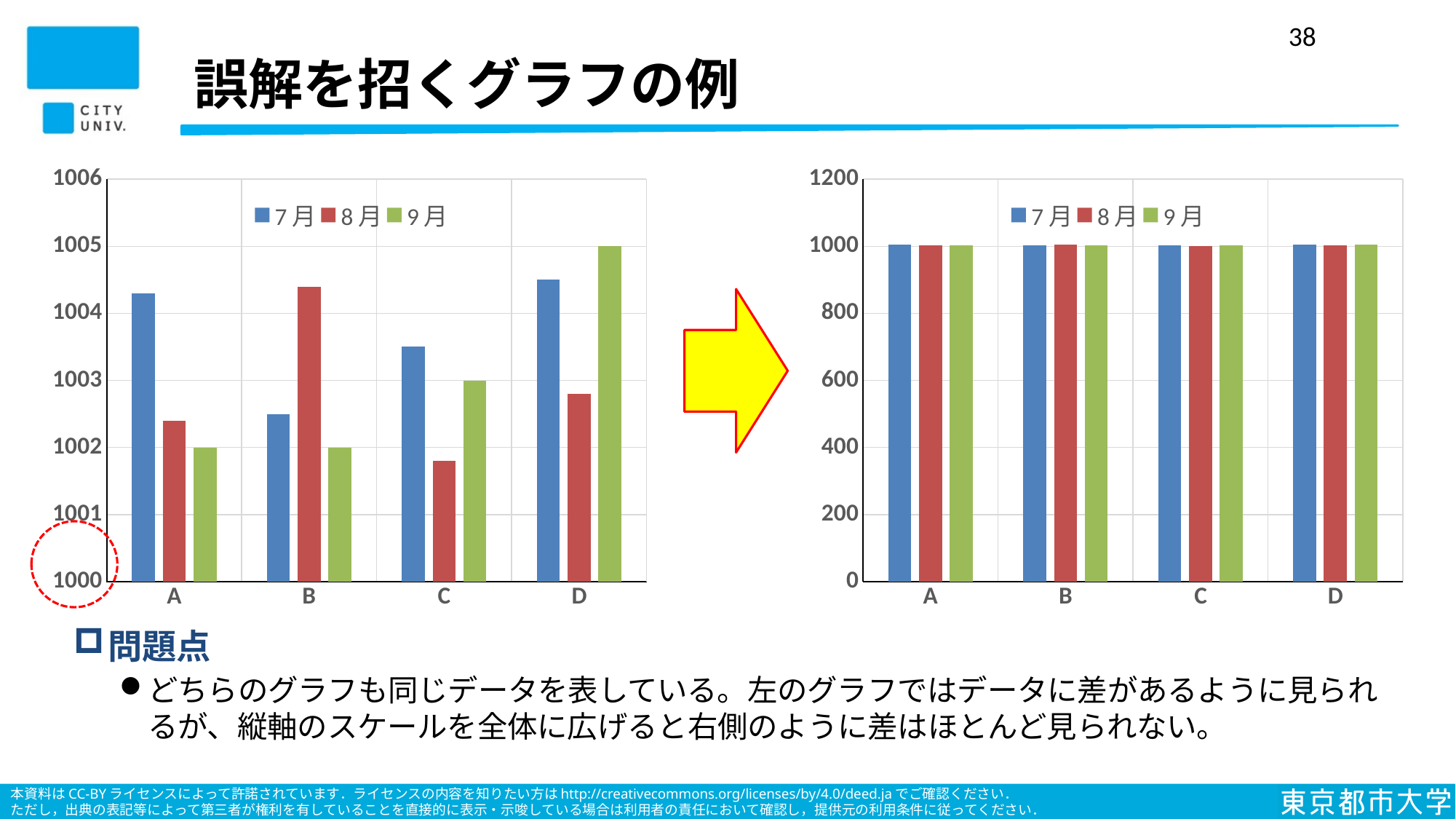
In the left chart, what is the value of 9月 for category C? 1003 In the left chart, which category has the highest 9月 value? D In the left chart, what is the value of 9月 for category D? 1005 What kind of chart is the left chart? bar chart How many series does the legend of the left chart list? 3 In the left chart, what is the value of 9月 for category A? 1002 In the left chart, is the value of 7月 for category D greater or less than 1004? greater In the left chart, what is the difference between the 9月 values for D and A? 3 How many categories are shown on the x axis of the right chart? 4 In the left chart, which is larger for category B: 7月 or 8月? 8月 In the left chart, which category has the lowest 8月 value? C In the right chart, is the value of 7月 for category A greater or less than 800? greater